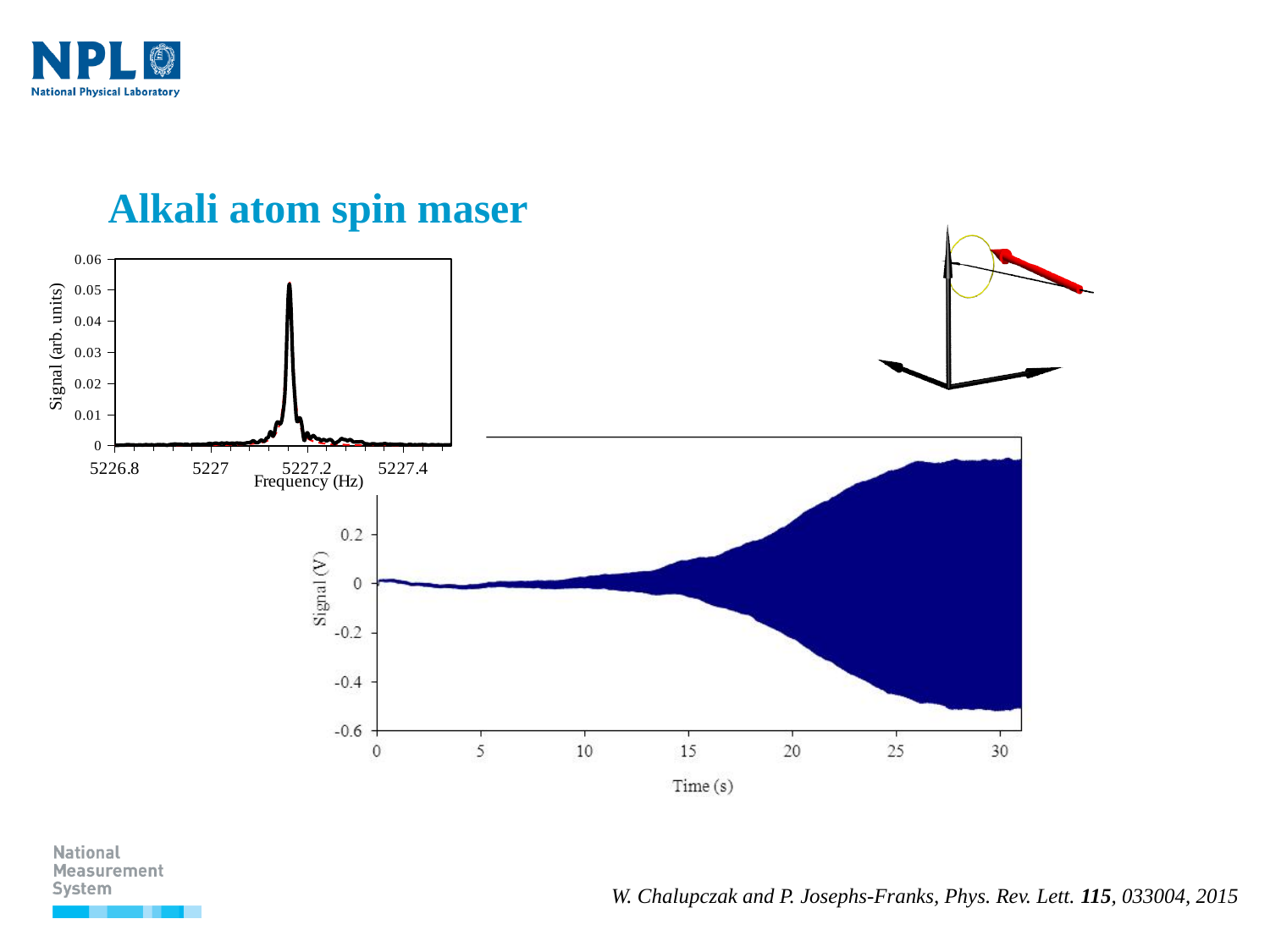
In the bottom chart with Time (s) on the x axis, what is the label of the y axis? Signal (V) In the top-left chart, is the peak signal value greater or less than 0.06? less In the top-left chart, what is the highest value shown on the y axis? 0.06 In the top-left chart, is the peak signal value greater or less than 0.04? greater In the top-left chart, which x-axis tick is the peak closest to: 5227 or 5227.2? 5227.2 In the top-left chart, what is the label of the y axis? Signal (arb. units) In the bottom chart, is the signal amplitude larger at 5 s or at 25 s? 25 s In the bottom chart, is the lower edge of the signal envelope at 30 s greater or less than -0.4 V? less What type of chart is the top-left chart with Frequency (Hz) on the x axis? line chart In the bottom chart, does the amplitude of the signal increase or decrease as time goes from 0 to 30 s? increase